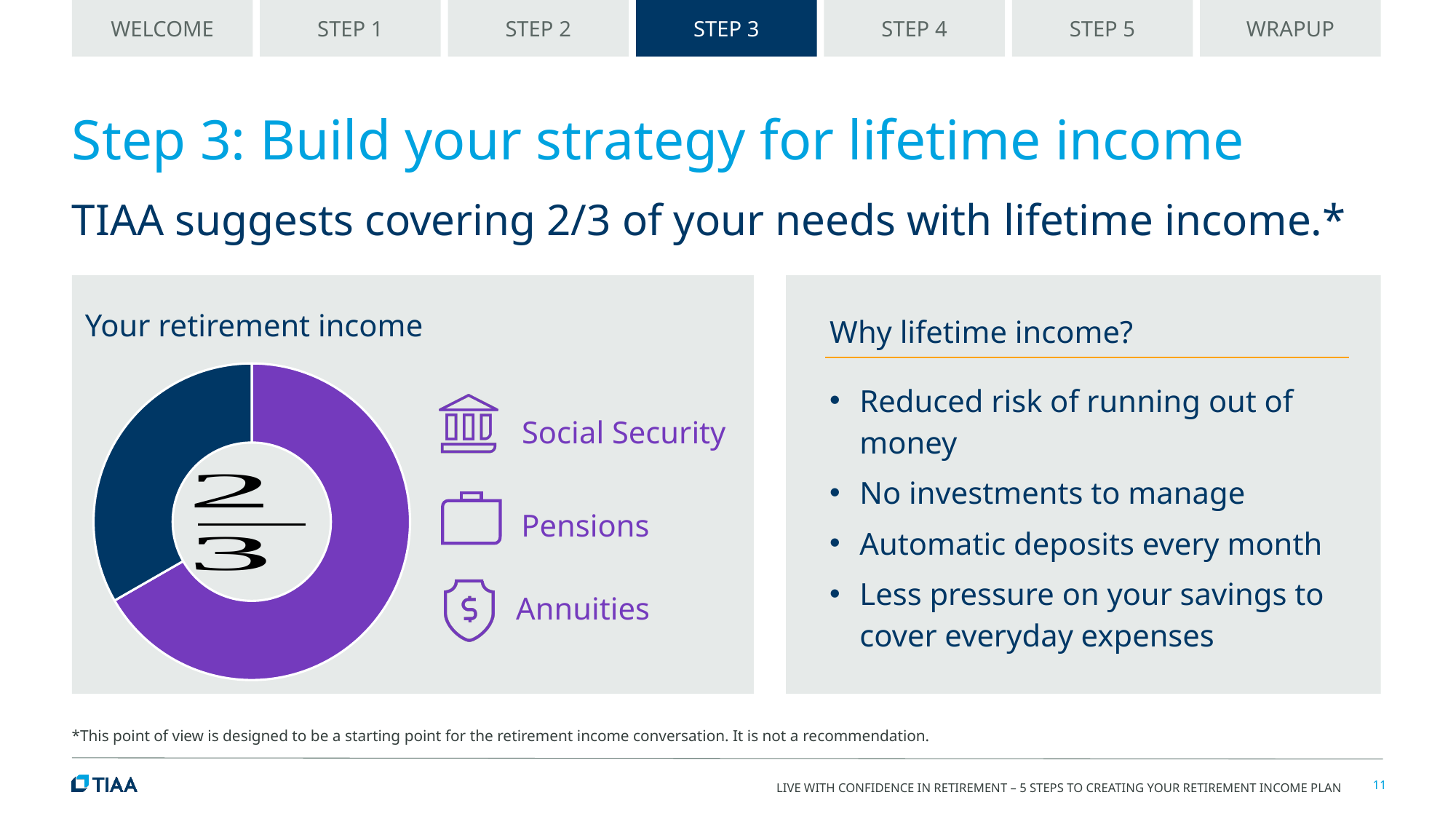
Which slice of the "Your retirement income" chart is larger, the purple one or the dark navy one? The purple one Is the purple slice of the "Your retirement income" chart greater or less than half of the chart? greater Which three income sources are listed in purple next to the "Your retirement income" chart? Social Security, Pensions, Annuities What share of the "Your retirement income" chart does the purple slice represent? 2/3 What kind of chart is shown under "Your retirement income"? Pie chart (donut) Which slice is the largest in the "Your retirement income" chart? The purple slice (lifetime income) Which slice is the smallest in the "Your retirement income" chart? The dark navy slice What fraction is printed in the center of the "Your retirement income" chart? 2/3 How many slices does the "Your retirement income" chart have? 2 What is the title of the chart on the left of the slide? Your retirement income